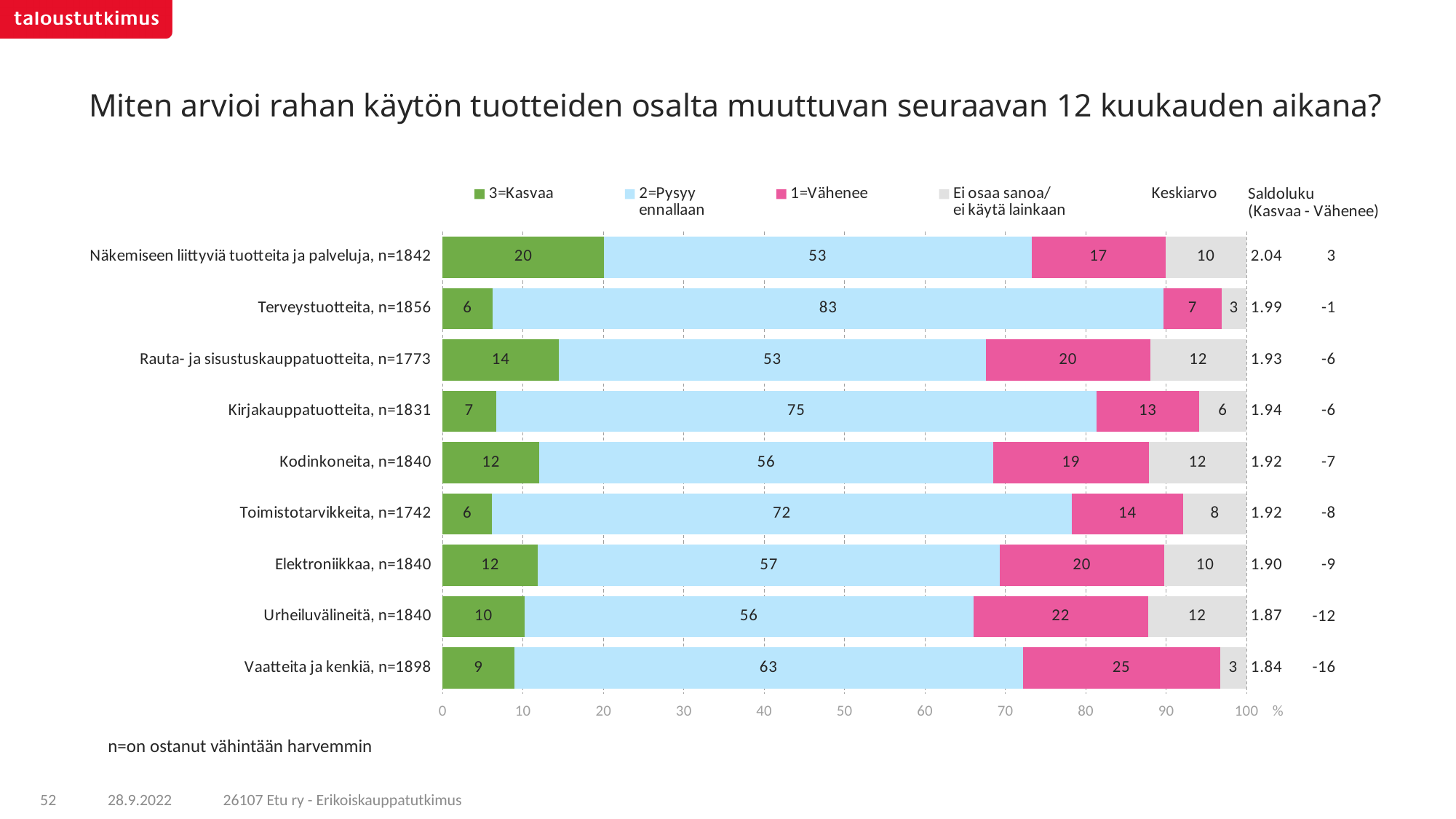
How many product categories are shown in the chart? 9 Which has a larger 2=Pysyy ennallaan value, Kirjakauppatuotteita, n=1831 or Toimistotarvikkeita, n=1742? Kirjakauppatuotteita, n=1831 What is the value of the Ei osaa sanoa/ei käytä lainkaan series for Rauta- ja sisustuskauppatuotteita, n=1773? 12 Which category has the highest value in the 3=Kasvaa series? Näkemiseen liittyviä tuotteita ja palveluja, n=1842 How many series does the chart legend list? 4 What is the value of the 2=Pysyy ennallaan series for Terveystuotteita, n=1856? 83 What is the Saldoluku (Kasvaa - Vähenee) value shown for Urheiluvälineitä, n=1840? -12 What is the total of the stacked bar for Näkemiseen liittyviä tuotteita ja palveluja, n=1842? 100 What kind of chart is shown on the slide? Stacked bar chart Which category has the highest value in the 1=Vähenee series? Vaatteita ja kenkiä, n=1898 What is the difference between the 1=Vähenee values for Urheiluvälineitä, n=1840 and Kodinkoneita, n=1840? 3 What is the value of the 3=Kasvaa series for Näkemiseen liittyviä tuotteita ja palveluja, n=1842? 20